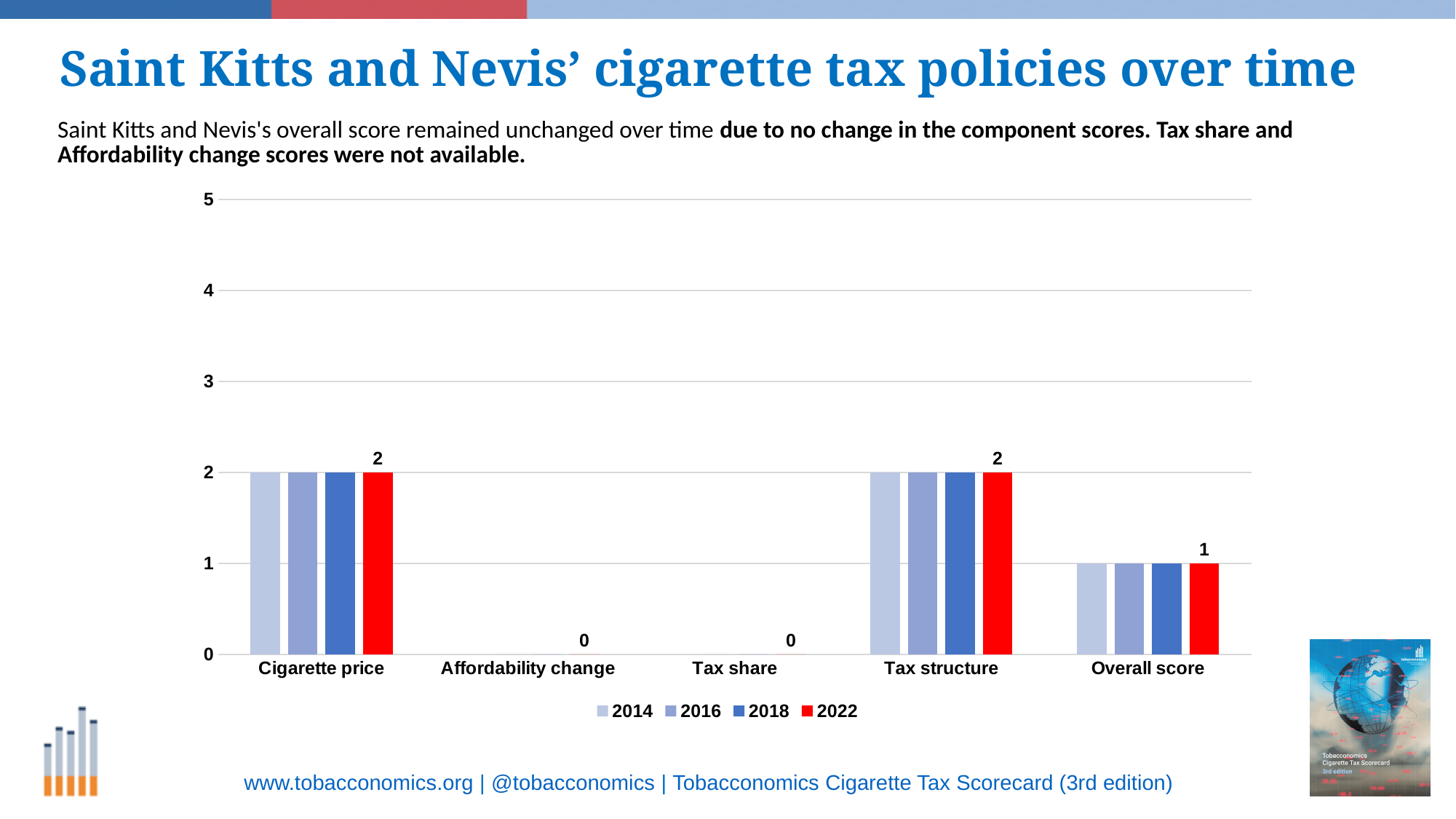
What is the 2022 value for Cigarette price? 2 What is the difference between the 2022 values for Cigarette price and Overall score? 1 What kind of chart is shown on the slide? bar chart What is the 2022 value for Overall score? 1 What is the 2022 value for Tax structure? 2 How many categories are shown on the x axis? 5 What is the 2014 value for Overall score? 1 Which is larger, the 2022 value for Tax structure or the 2022 value for Overall score? Tax structure How many series does the legend list? 4 Which category has the lowest 2022 value among Cigarette price, Tax structure and Overall score? Overall score Is the 2018 value for Cigarette price greater or less than 3? less What is the 2022 value for Affordability change? 0